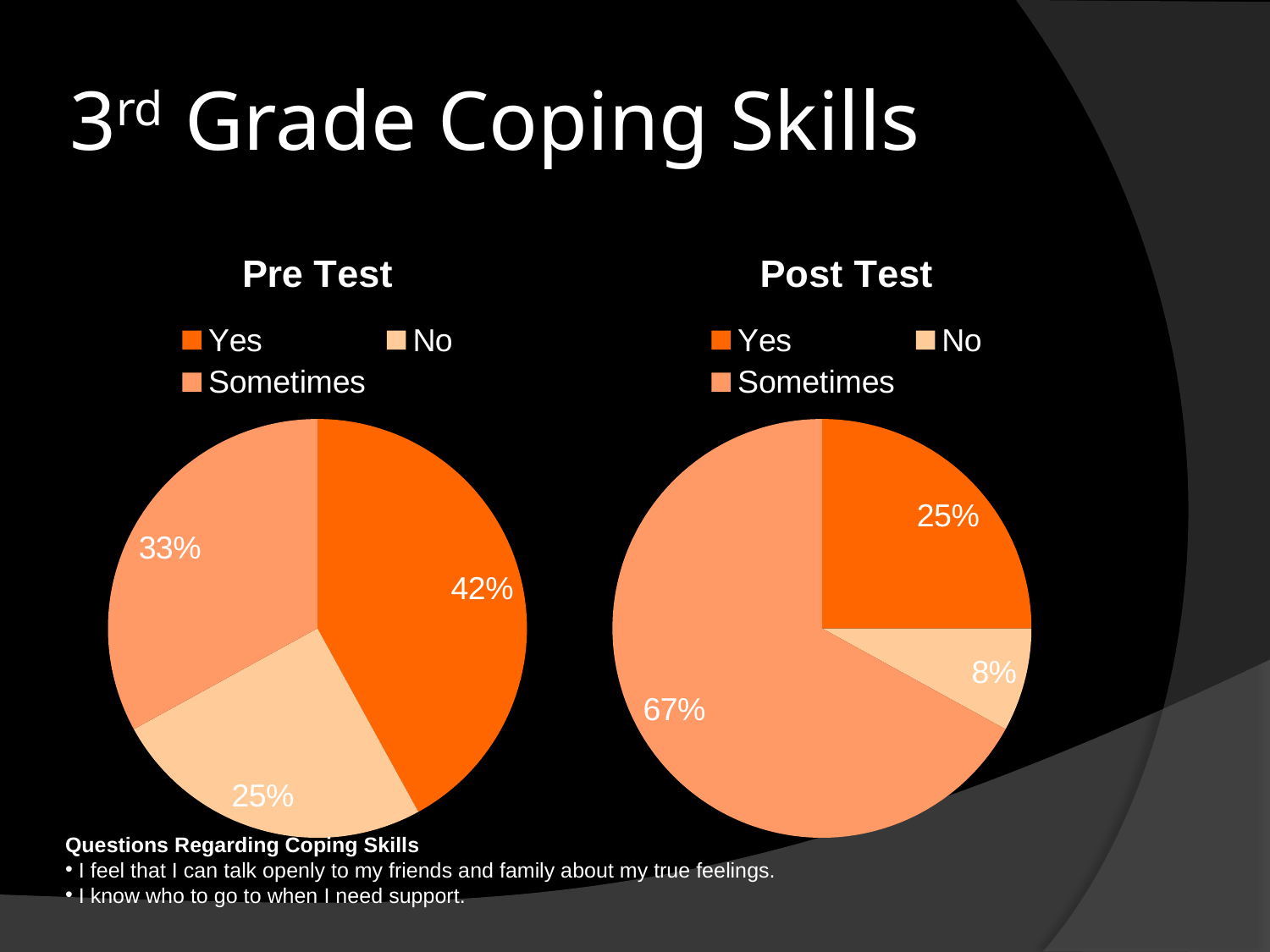
In the Pre Test pie chart, what percentage is shown for Sometimes? 33% In the Post Test pie chart, what percentage is shown for Sometimes? 67% In the Post Test pie chart, what percentage is shown for No? 8% How many categories does the legend of the Post Test chart list? 3 What is the difference between the Yes percentage in the Pre Test chart and the Yes percentage in the Post Test chart? 17% In the Pre Test pie chart, what percentage is shown for Yes? 42% In the Post Test pie chart, which category has the smallest slice? No In the Pre Test pie chart, which category has the smallest slice? No In the Pre Test pie chart, which is larger, the Yes slice or the Sometimes slice? Yes In the Pre Test pie chart, what percentage is shown for No? 25% What type of chart is the Pre Test chart? Pie chart In the Post Test pie chart, which category has the largest slice? Sometimes